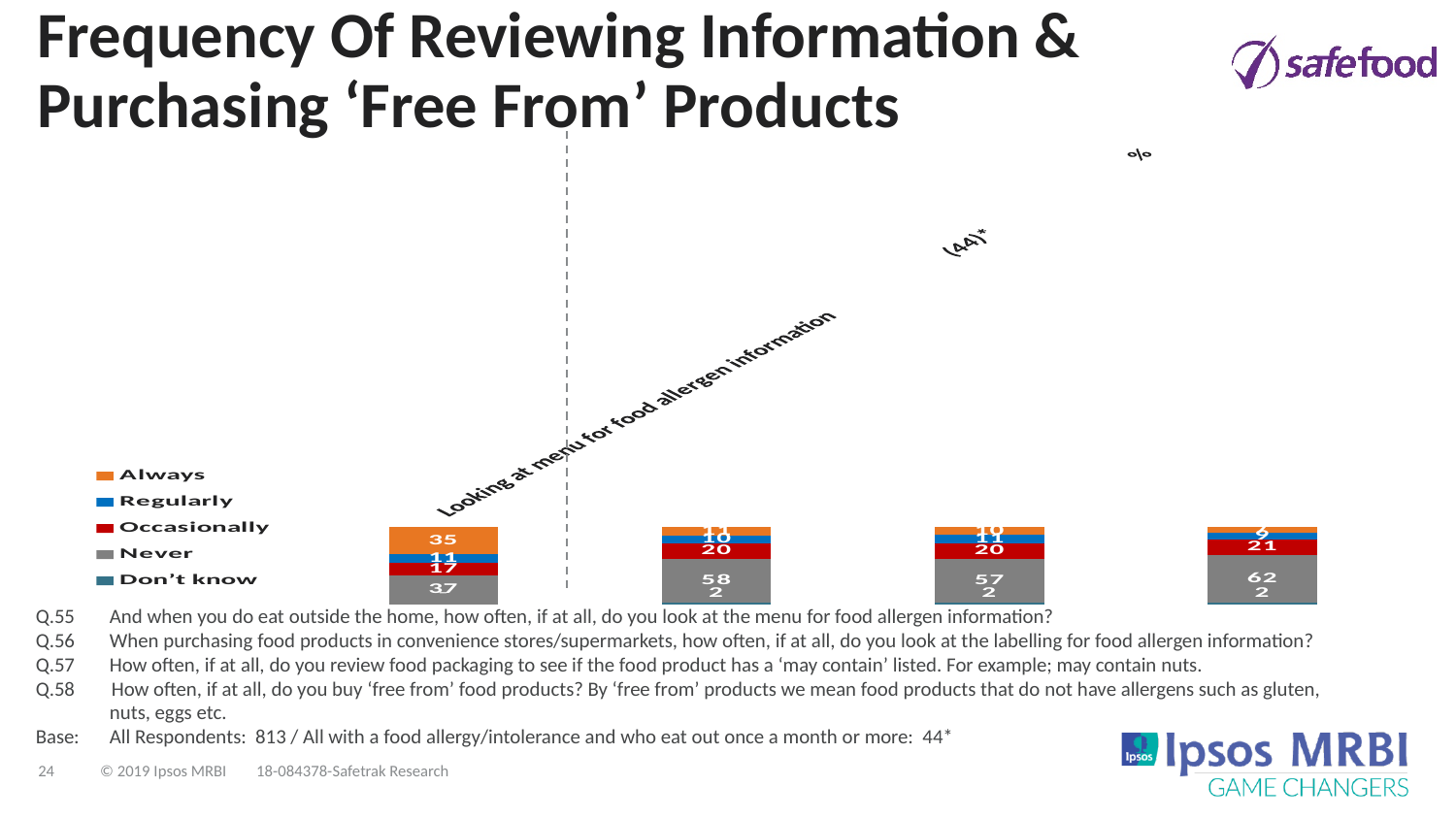
How many stacked bars are plotted in the chart? 4 For 'Looking at menu for food allergen information', what is the difference between the 'Never' value and the 'Always' value? 2 What base size is shown in brackets next to the 'Looking at menu for food allergen information' label? (44)* What is the 'Always' value for 'Looking at menu for food allergen information'? 35 Which colour represents 'Always' in the chart legend? Orange How many series does the chart legend list? 5 What is the 'Regularly' value for 'Looking at menu for food allergen information'? 11 For 'Looking at menu for food allergen information', which is larger: the 'Always' value or the 'Occasionally' value? Always What is the 'Occasionally' value for 'Looking at menu for food allergen information'? 17 Which response category has the largest value in the 'Looking at menu for food allergen information' bar? Never What kind of chart is shown on the slide? Stacked bar chart What is the 'Never' value for 'Looking at menu for food allergen information'? 37